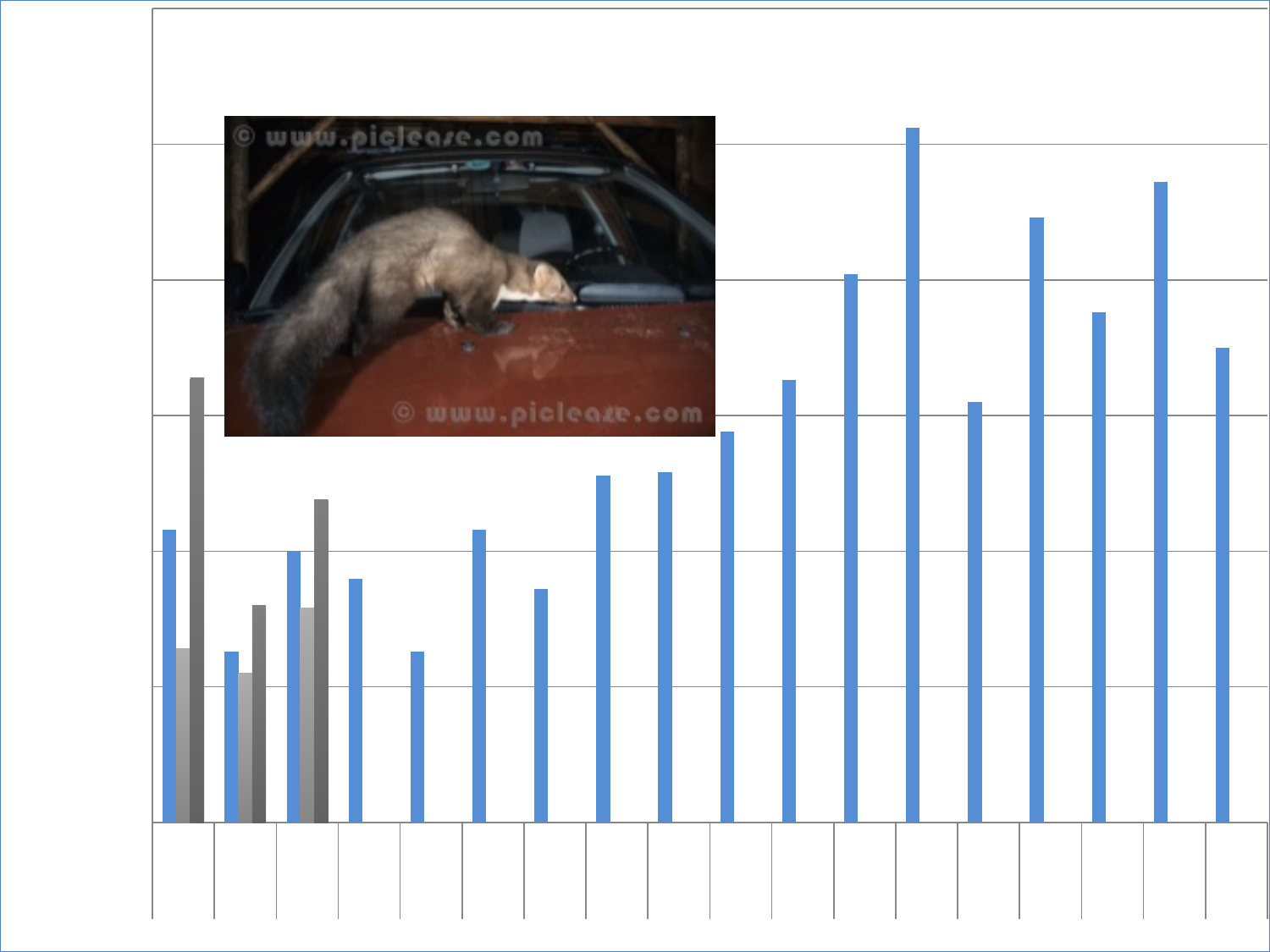
How many categories (groups of bars) are plotted along the x axis? 18 Counting from the left, which blue bar is the tallest? the 13th What kind of chart is shown on the slide? bar chart How many of the categories have additional grey bars next to the blue bar? 3 Do the blue bars generally rise or fall from left to right along the x axis? rise What colour are most of the bars in the chart? blue